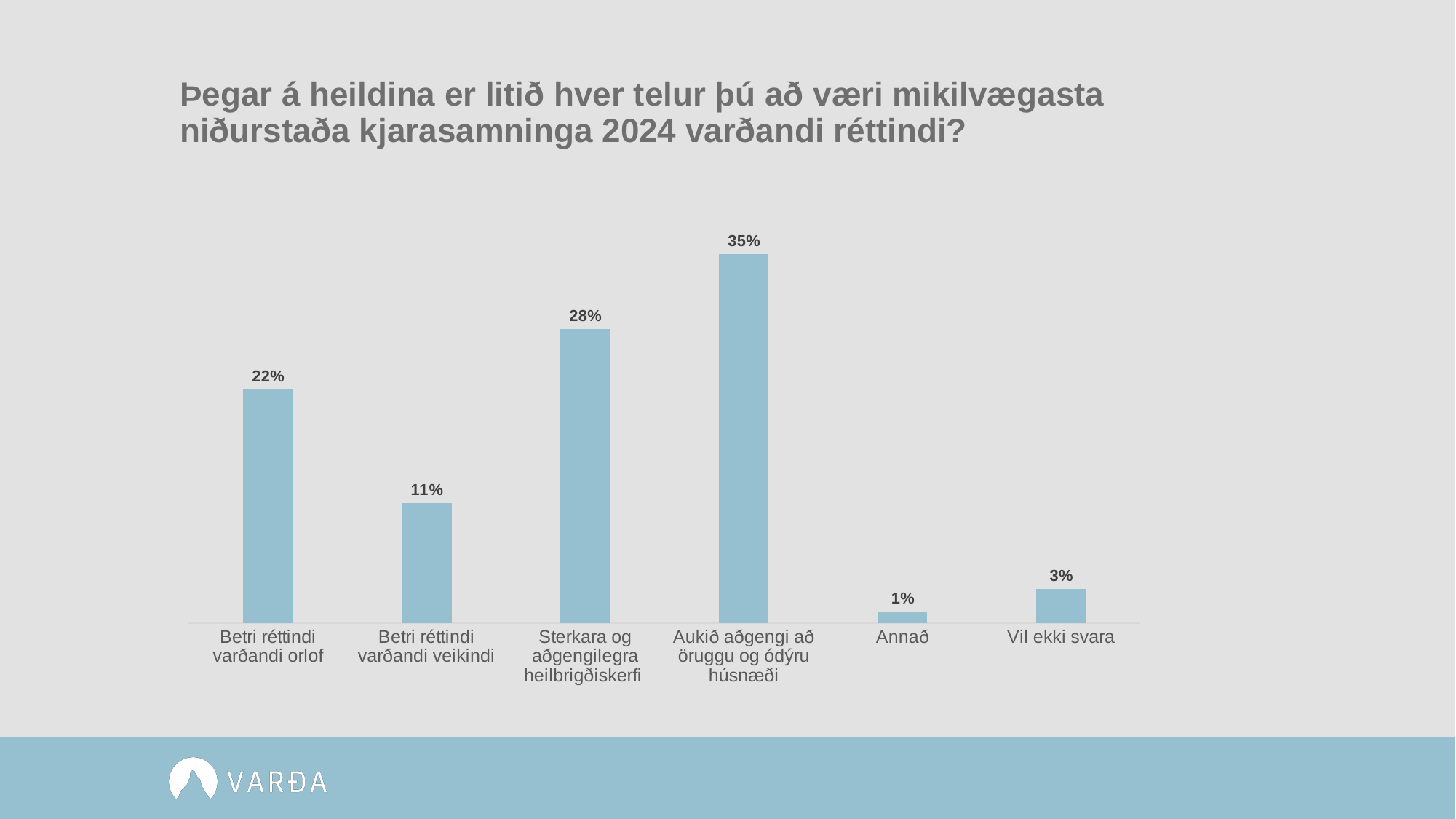
How many categories are shown on the chart? 6 Which is larger, the value for "Betri réttindi varðandi orlof" or the value for "Betri réttindi varðandi veikindi"? Betri réttindi varðandi orlof What is the difference between the values for "Aukið aðgengi að öruggu og ódýru húsnæði" and "Sterkara og aðgengilegra heilbrigðiskerfi"? 7% Which category has the highest value? Aukið aðgengi að öruggu og ódýru húsnæði What is the value for "Sterkara og aðgengilegra heilbrigðiskerfi"? 28% What is the value for "Betri réttindi varðandi orlof"? 22% What kind of chart is shown on the slide? Bar chart What is the difference between the values for "Betri réttindi varðandi orlof" and "Betri réttindi varðandi veikindi"? 11% What is the value for "Aukið aðgengi að öruggu og ódýru húsnæði"? 35% What is the value for "Betri réttindi varðandi veikindi"? 11% Which category has the lowest value? Annað What is the value for "Vil ekki svara"? 3%